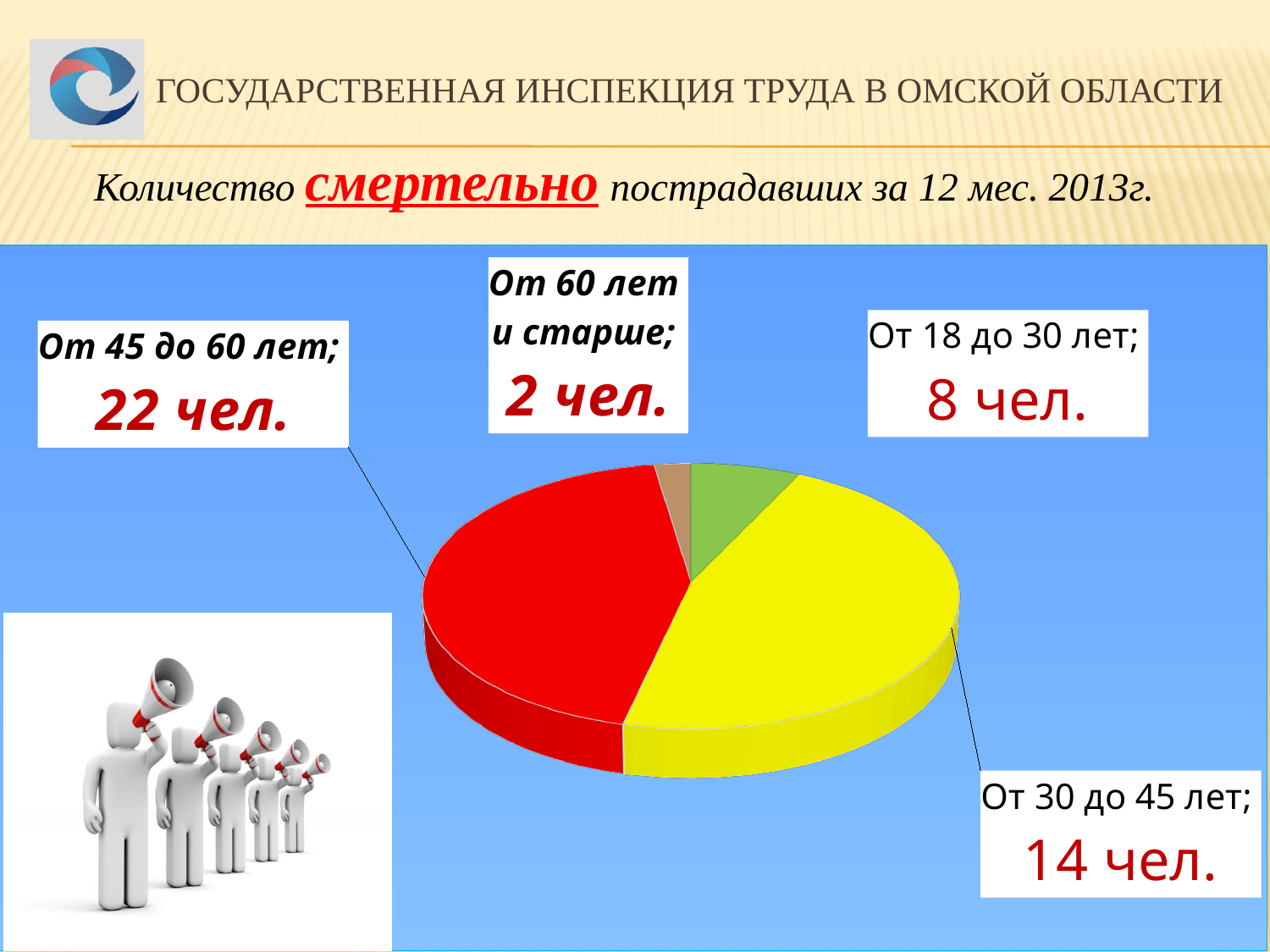
What is the value for the category "От 45 до 60 лет"? 22 чел. What is the value for the category "От 30 до 45 лет"? 14 чел. What is the value for the category "От 18 до 30 лет"? 8 чел. Which colour is the slice for "От 45 до 60 лет"? red What kind of chart is shown on the slide? pie chart How many slices does the pie chart have? 4 What is the difference between the values for "От 45 до 60 лет" and "От 30 до 45 лет"? 8 чел. What is the total number of people across all four slices of the pie chart? 46 чел. Which age category has the highest number of fatally injured people? От 45 до 60 лет What is the value for the category "От 60 лет и старше"? 2 чел. Which age category has the lowest number of fatally injured people? От 60 лет и старше Which is larger: the value for "От 18 до 30 лет" or for "От 30 до 45 лет"? От 30 до 45 лет